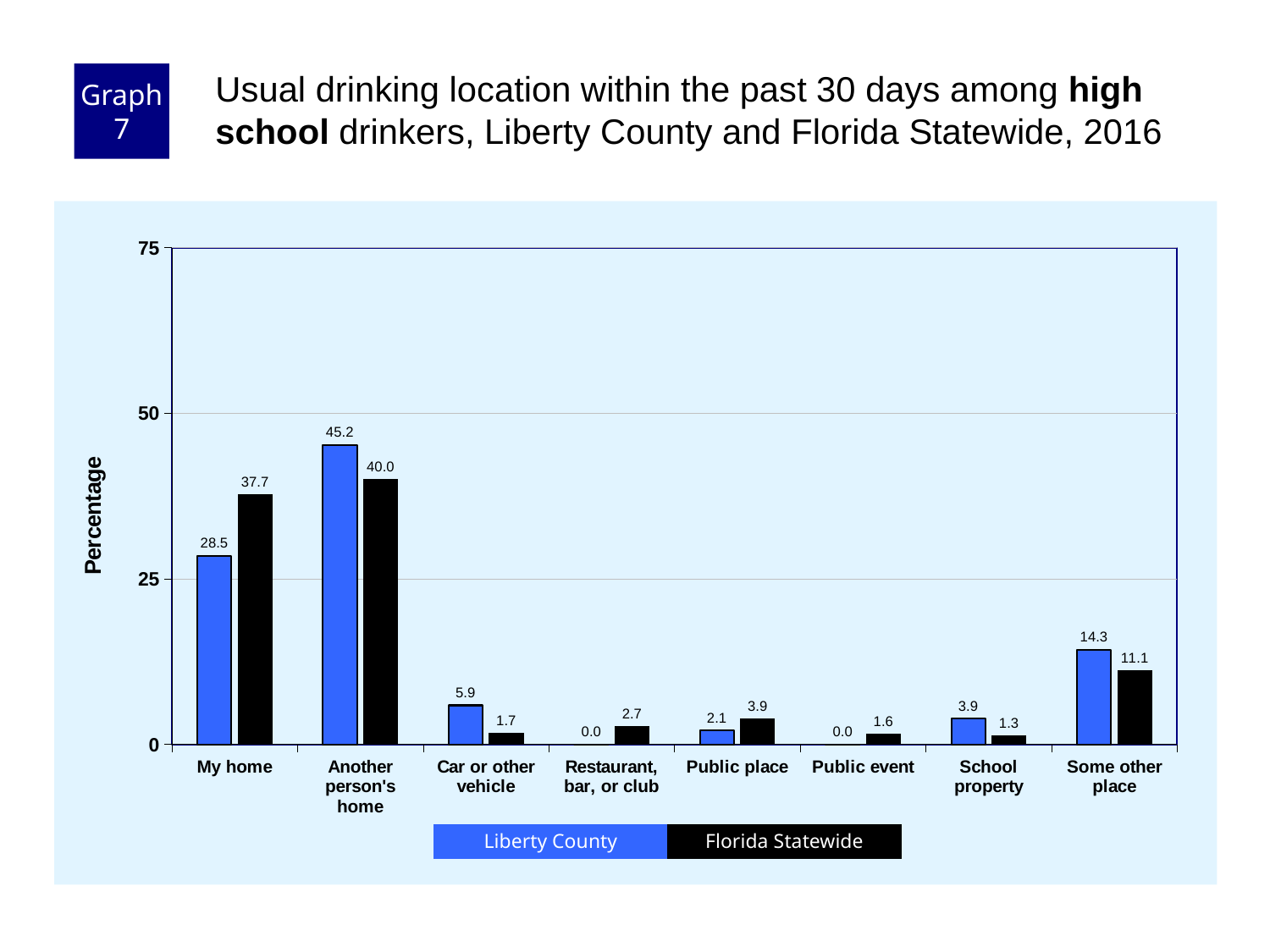
What is the difference between the Liberty County and Florida Statewide values for "Another person's home"? 5.2 What is the Florida Statewide value for "My home"? 37.7 Is the Liberty County value for "My home" greater or less than 25? greater Which category has the lowest Florida Statewide value? School property What kind of chart is shown on the slide? Bar chart How many series does the legend list? 2 How many categories are shown on the x axis? 8 Which colour represents Florida Statewide in the chart? Black Which is larger for "My home": Liberty County or Florida Statewide? Florida Statewide What is the Liberty County value for "Some other place"? 14.3 Which category has the highest Liberty County value? Another person's home What is the Liberty County value for "Another person's home"? 45.2